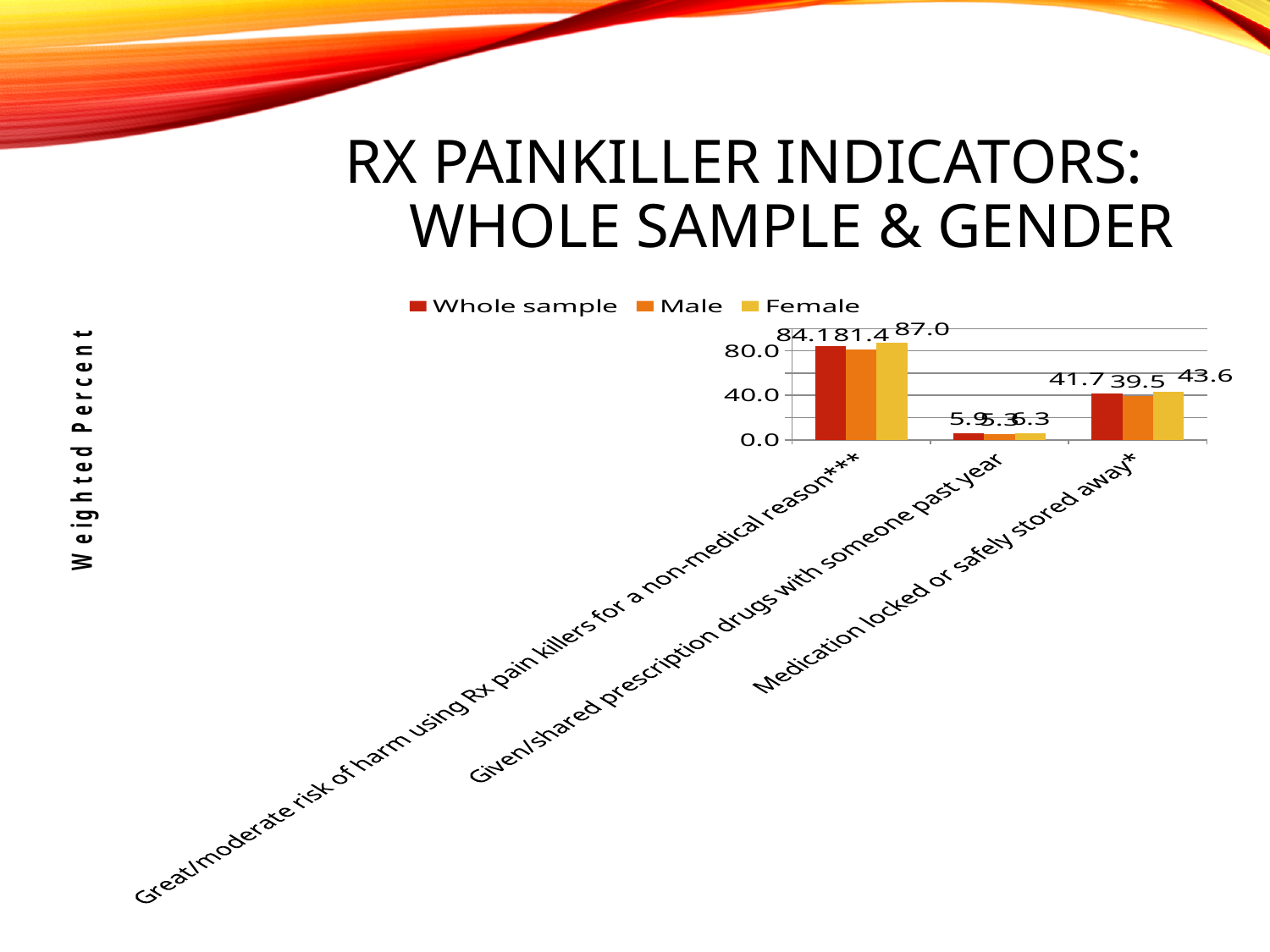
What is the Whole sample value for 'Great/moderate risk of harm using Rx pain killers for a non-medical reason***'? 84.1 What is the Male value for 'Great/moderate risk of harm using Rx pain killers for a non-medical reason***'? 81.4 How many series does the legend list? 3 What is the difference between the Female and Male values for 'Great/moderate risk of harm using Rx pain killers for a non-medical reason***'? 5.6 What kind of chart is shown on the slide? Bar chart Which category has the lowest values across all series? Given/shared prescription drugs with someone past year Is the Female value for 'Medication locked or safely stored away*' greater or less than 40.0? greater Which category has the highest values across all series? Great/moderate risk of harm using Rx pain killers for a non-medical reason*** For 'Medication locked or safely stored away*', which is larger: the Whole sample value or the Male value? Whole sample How many categories are shown on the x axis? 3 What is the Male value for 'Medication locked or safely stored away*'? 39.5 What is the Female value for 'Medication locked or safely stored away*'? 43.6